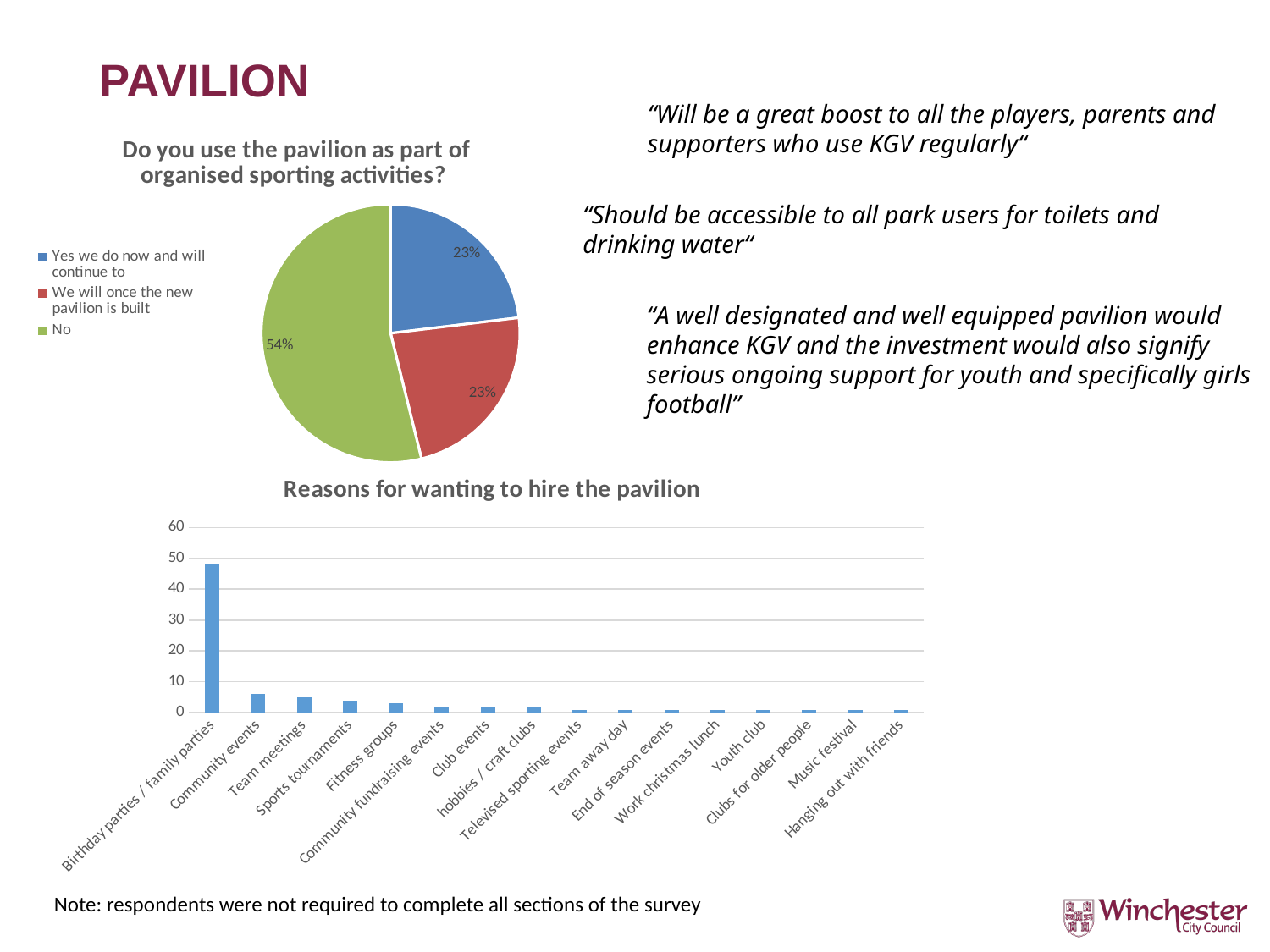
What kind of chart is 'Reasons for wanting to hire the pavilion'? Bar chart In the pie chart 'Do you use the pavilion as part of organised sporting activities?', what share of respondents answered 'No'? 54% In the chart 'Reasons for wanting to hire the pavilion', is the value for 'Community events' greater or less than 10? less In the pie chart 'Do you use the pavilion as part of organised sporting activities?', what share answered 'Yes we do now and will continue to'? 23% In the chart 'Reasons for wanting to hire the pavilion', which is larger: the value for 'Birthday parties / family parties' or the value for 'Team meetings'? Birthday parties / family parties How many reasons are shown on the x axis of the chart 'Reasons for wanting to hire the pavilion'? 16 In the pie chart 'Do you use the pavilion as part of organised sporting activities?', how many response categories does the legend list? 3 In the chart 'Reasons for wanting to hire the pavilion', which reason has the highest value? Birthday parties / family parties In the pie chart 'Do you use the pavilion as part of organised sporting activities?', which response has the largest share? No In the pie chart 'Do you use the pavilion as part of organised sporting activities?', how many percentage points larger is the 'No' share than the 'Yes we do now and will continue to' share? 31 percentage points In the chart 'Reasons for wanting to hire the pavilion', is the value for 'Birthday parties / family parties' greater or less than 40? greater In the pie chart 'Do you use the pavilion as part of organised sporting activities?', what colour is the 'No' slice? Green